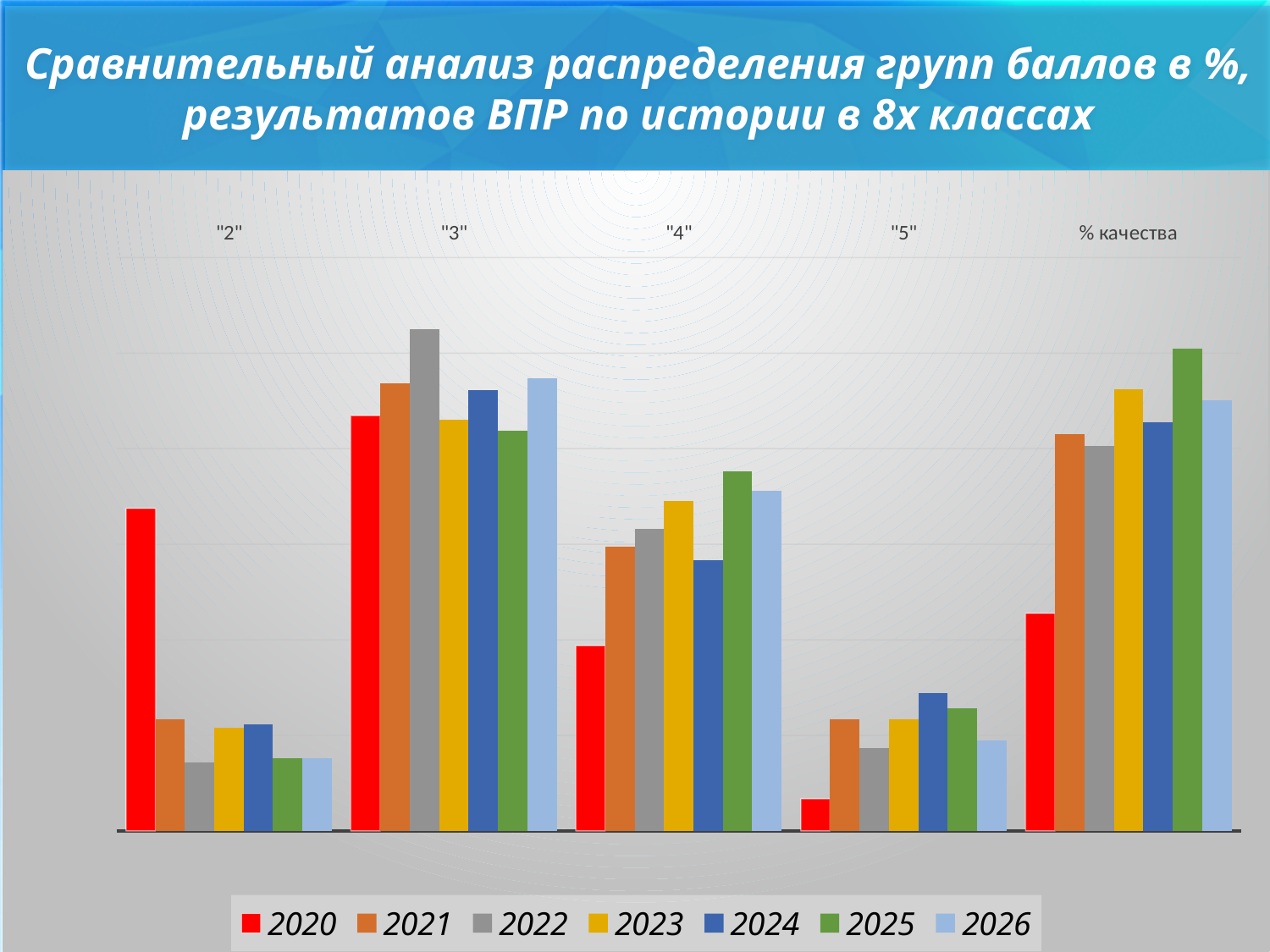
In the "% качества" category, which year has the lowest bar? 2020 How many categories are shown along the x axis? 5 In the "3" category, which year has the highest bar? 2022 In the "5" category, which year has the lowest bar? 2020 In the "5" category, which year has the highest bar? 2024 In the "% качества" category, which year has the highest bar? 2025 What kind of chart is shown on the slide? bar chart In the "4" category, which is larger: the bar for 2025 or the bar for 2024? 2025 Which colour represents the 2020 series in the legend? red How many series does the legend list? 7 In the "4" category, which year has the lowest bar? 2020